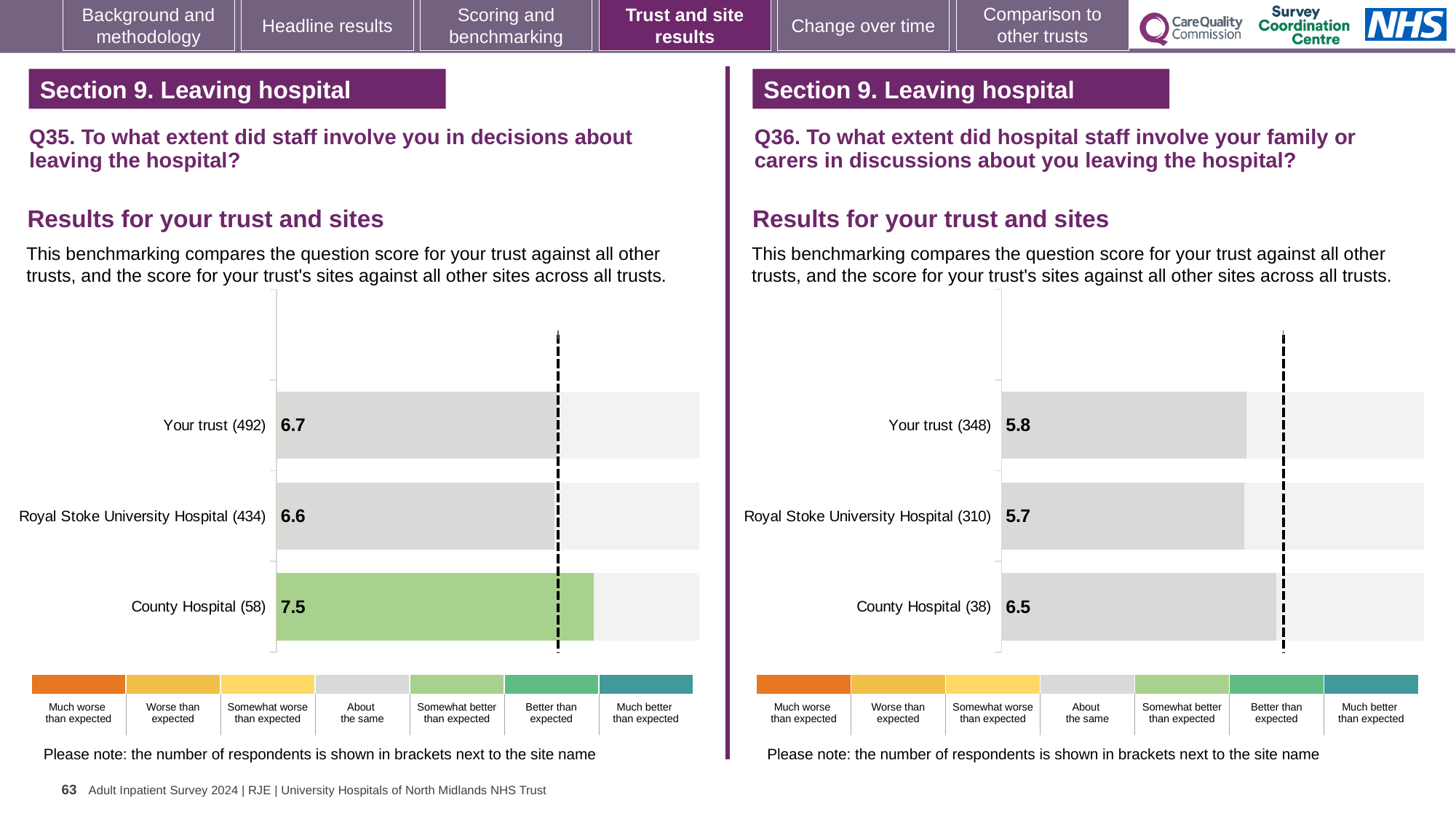
In the Q35 chart on the left, what is the score for County Hospital? 7.5 In the Q36 chart on the right, what is the score for Royal Stoke University Hospital? 5.7 In the Q36 chart on the right, what is the difference between the County Hospital score and the Royal Stoke University Hospital score? 0.8 What type of chart is used for the Q35 results on the left? Bar chart In the Q36 chart on the right, what is the score for County Hospital? 6.5 In the Q35 chart on the left, which site or trust has the highest score? County Hospital In the Q36 chart on the right, which site or trust has the lowest score? Royal Stoke University Hospital Which is larger: the Your trust score in the Q35 chart on the left or the Your trust score in the Q36 chart on the right? Q35 (6.7) In the Q35 chart on the left, what is the score for Your trust? 6.7 How many bars are plotted in the Q36 chart on the right? 3 In the Q35 chart on the left, how many respondents are shown in brackets for Royal Stoke University Hospital? 434 In the Q35 chart on the left, what is the difference between the County Hospital score and the Your trust score? 0.8